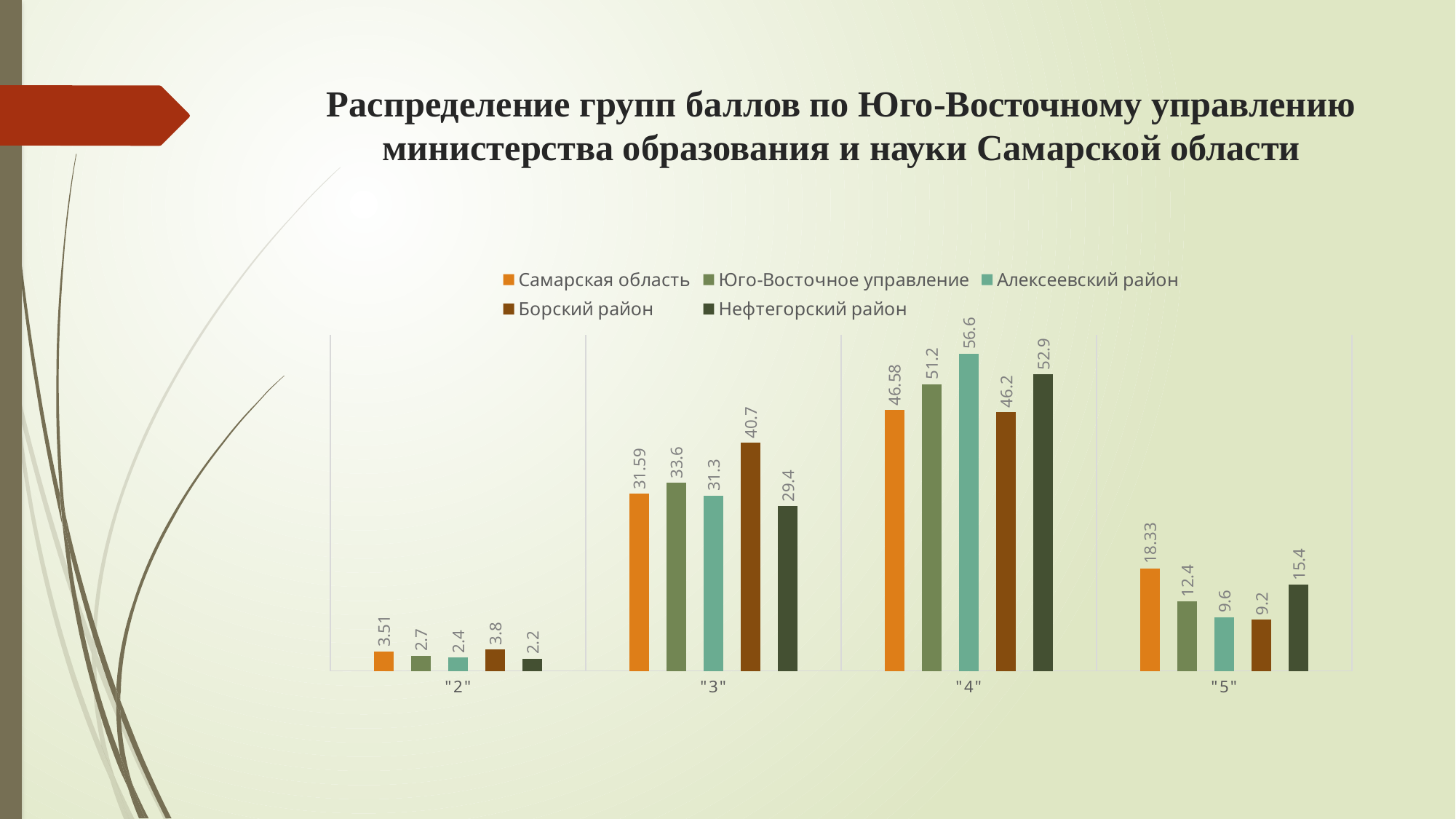
What is the difference between Алексеевский район and Борский район in the "4" category? 10.4 What is the value for Самарская область in the "3" category? 31.59 What is the value for Нефтегорский район in the "2" category? 2.2 Which category has the highest values across all series? "4" In the "5" category, which is larger: Самарская область or Нефтегорский район? Самарская область How many categories are shown on the x axis? 4 What is the value for Алексеевский район in the "4" category? 56.6 How many series does the legend list? 5 What is the value for Борский район in the "5" category? 9.2 Which series has the highest value in the "3" category? Борский район What kind of chart is shown on the slide? Bar chart Which series has the lowest value in the "5" category? Борский район